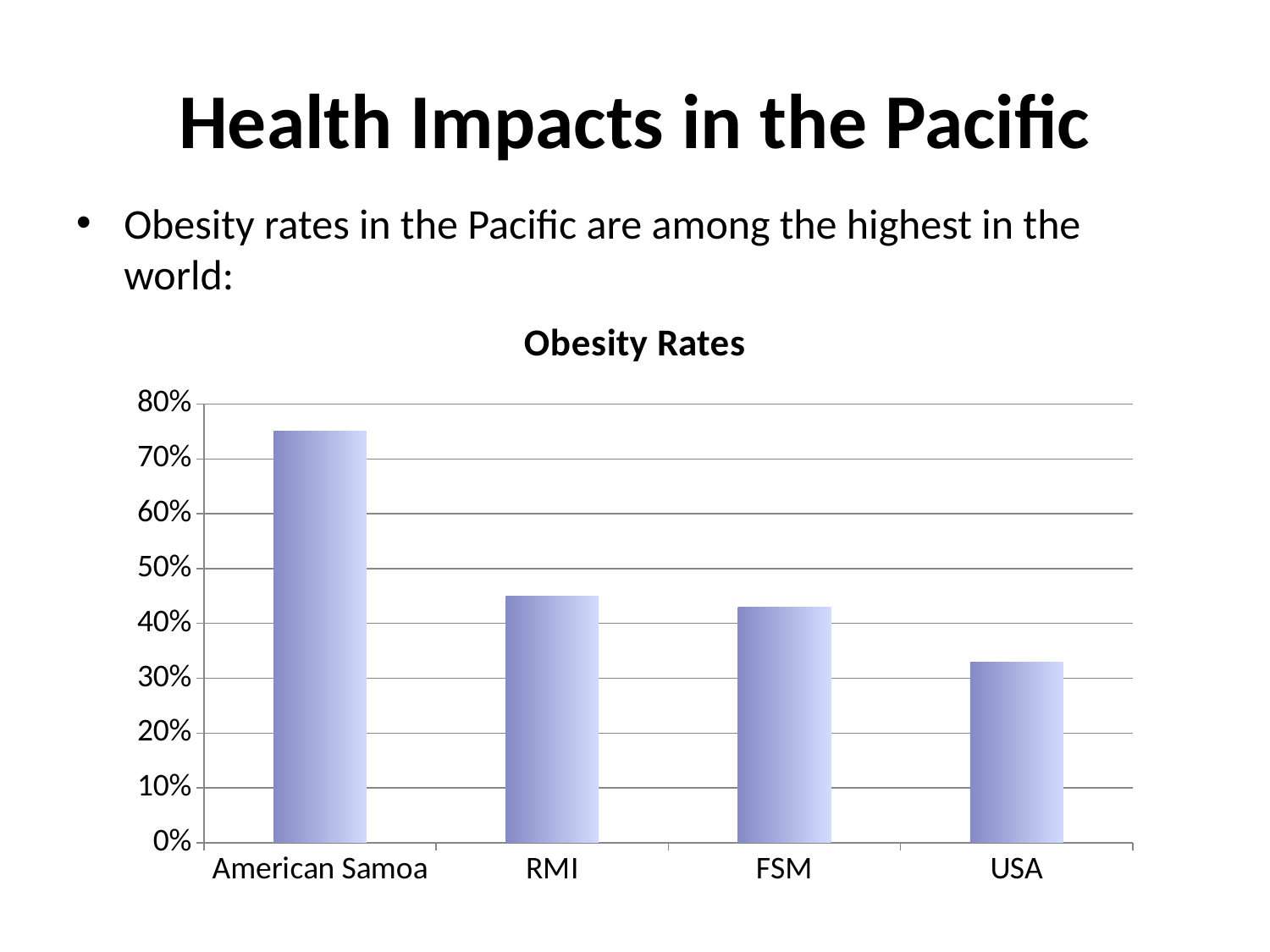
Do the values rise or fall moving from left to right along the x axis? fall What type of chart is shown on the slide? bar chart Which category has the lowest obesity rate in the chart? USA Which has a higher obesity rate, RMI or USA? RMI How many categories are shown on the x axis of the chart? 4 Is the value for American Samoa greater or less than 70%? greater Which category has the highest obesity rate in the chart? American Samoa Is the value for RMI greater or less than 50%? less Is the value for FSM greater or less than 40%? greater Which has a higher obesity rate, American Samoa or USA? American Samoa What is the title of the chart? Obesity Rates